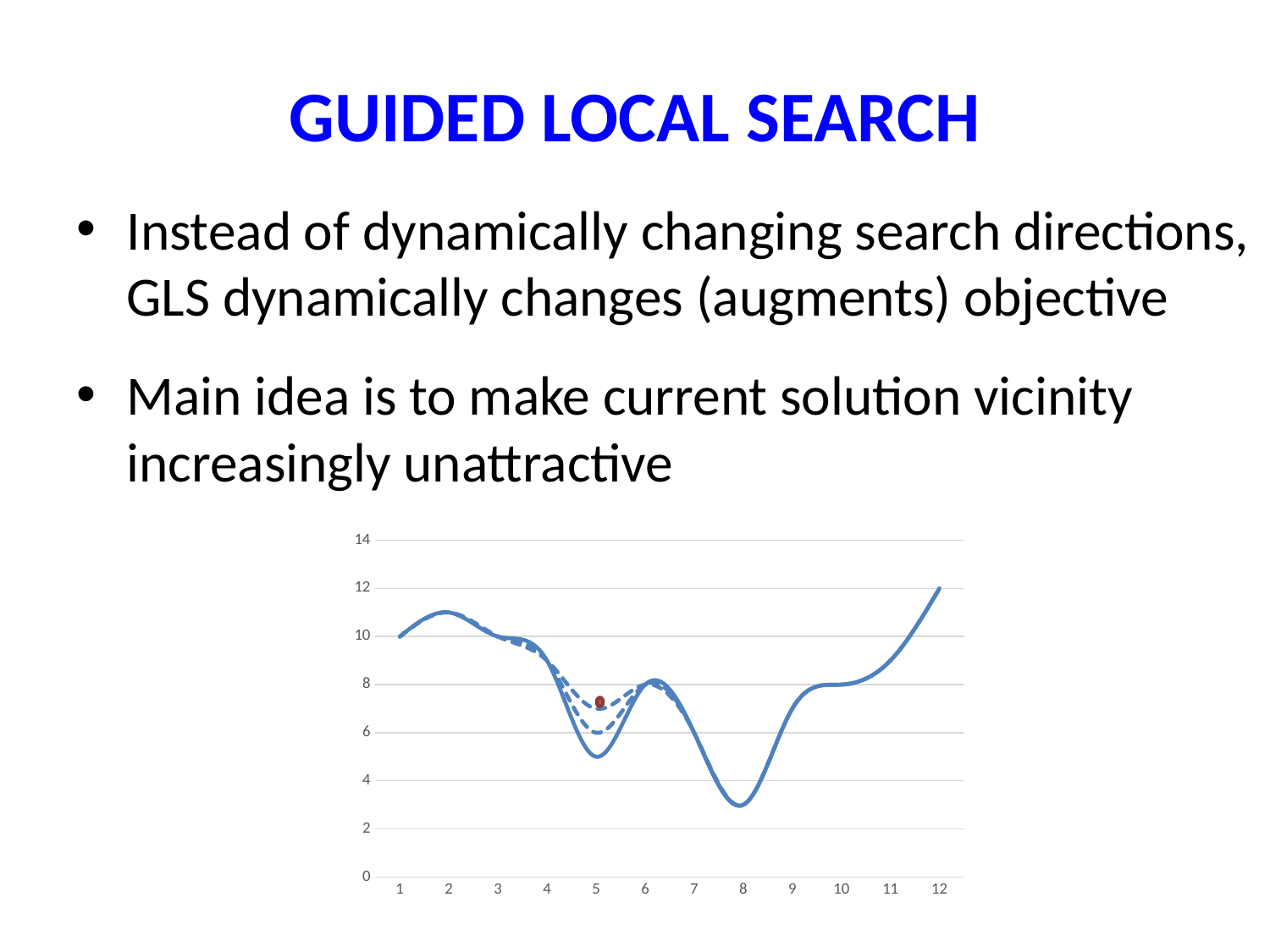
At which x value does the solid line reach its lowest point? 8 Is the value of the solid line at x = 11 greater or less than 8? greater What is the value of the solid line at x = 12? 12 Does the solid line rise or fall between x = 8 and x = 12? rise Is the value of the solid line at x = 2 greater or less than 10? greater What is the value of the solid line at x = 1? 10 Is the value of the solid line at x = 5 greater or less than 6? less What kind of chart is shown on the slide? line chart At which x value does the solid line reach its highest point? 12 Near which x value are the dashed lines and the red marker drawn? 5 How many points are labelled along the x axis of the chart? 12